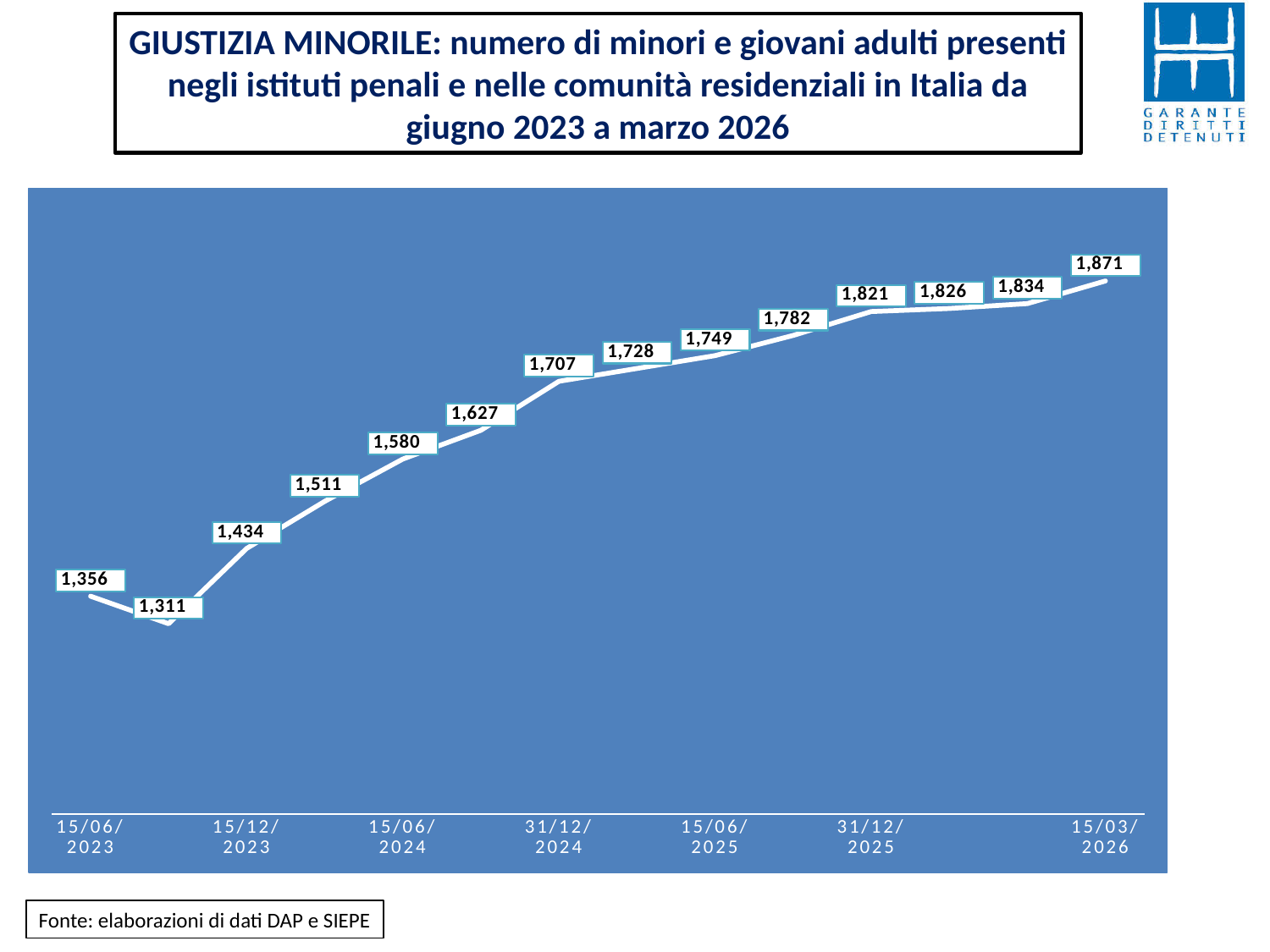
How many data points are plotted on the line? 14 What source is cited for the data on the slide? elaborazioni di dati DAP e SIEPE Which date has the highest value on the chart? 15/03/2026 What is the value for 15/06/2023? 1,356 What is the difference between the value for 15/03/2026 and the value for 15/06/2023? 515 Do the values generally rise or fall from left to right along the x axis? rise What is the value for 15/03/2026? 1,871 What is the value for 15/06/2025? 1,749 What is the lowest value plotted on the chart? 1,311 Which is larger, the value for 15/12/2023 or the value for 15/06/2024? 15/06/2024 What kind of chart is shown on the slide? line chart What is the value for 31/12/2024? 1,707